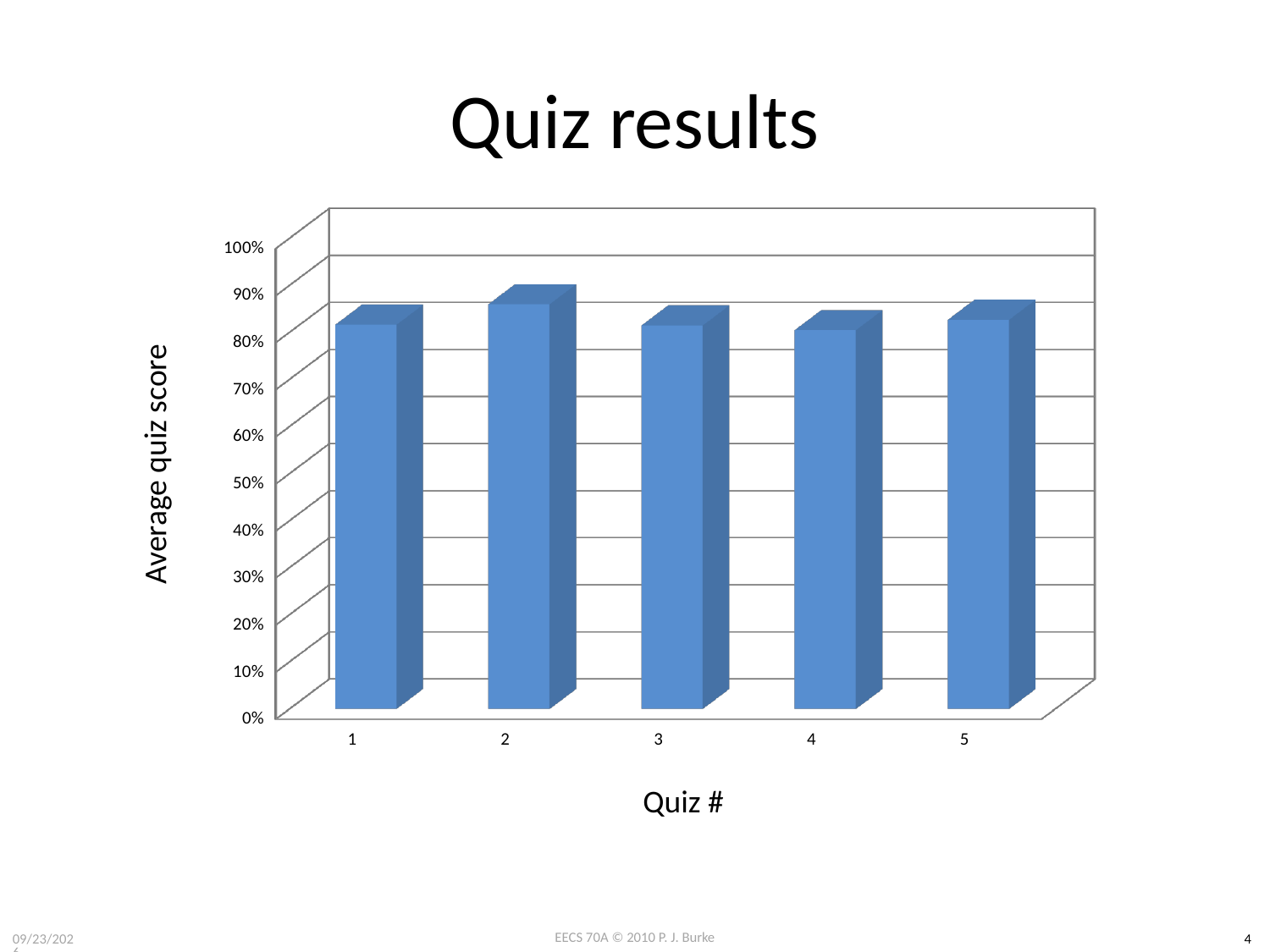
Is the average quiz score for quiz 4 greater or less than 70%? greater What is the title of the chart? Quiz results Which has the larger average quiz score, quiz 2 or quiz 4? quiz 2 Is the average quiz score for quiz 2 greater or less than 80%? greater How many quizzes are plotted on the chart? 5 What is the label on the vertical axis of the chart? Average quiz score Is the average quiz score for quiz 5 greater or less than 50%? greater Which quiz has the highest average quiz score? 2 What kind of chart is shown on the slide? bar chart